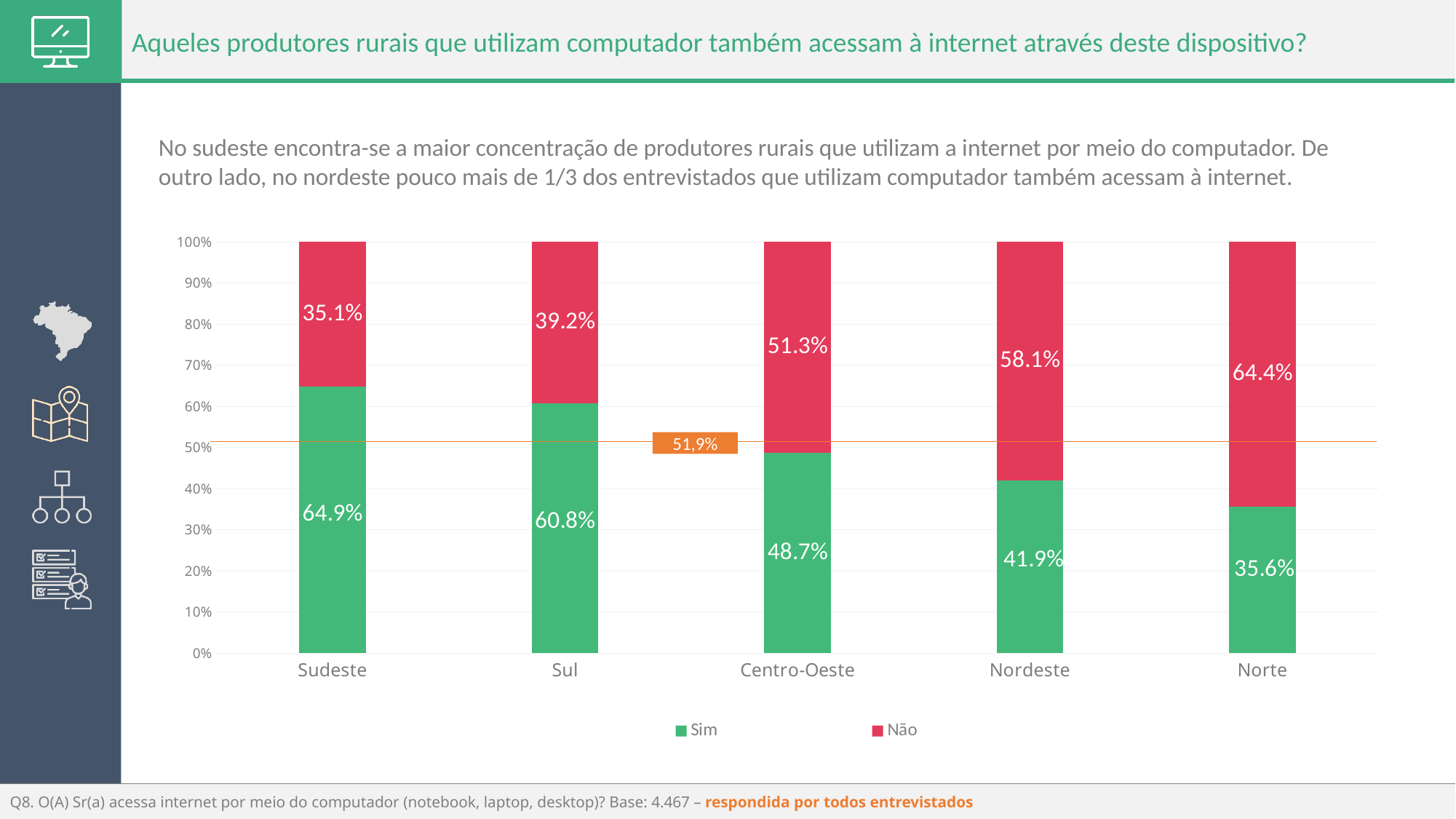
Which region has the lowest 'Sim' value? Norte Which region has the highest 'Sim' value? Sudeste How many regions are shown on the x axis? 5 How many series does the legend list? 2 Which is larger, the 'Sim' value for Sul or the 'Sim' value for Nordeste? Sul What value is shown on the orange horizontal reference line? 51,9% What is the difference between the 'Não' values for Norte and Sudeste? 29.3% What is the 'Não' value for Nordeste? 58.1% What is the 'Sim' value for Sudeste? 64.9% What kind of chart is shown? Stacked bar chart What is the 'Sim' value for Centro-Oeste? 48.7% Do the 'Sim' values rise or fall from Sudeste to Norte along the x axis? Fall